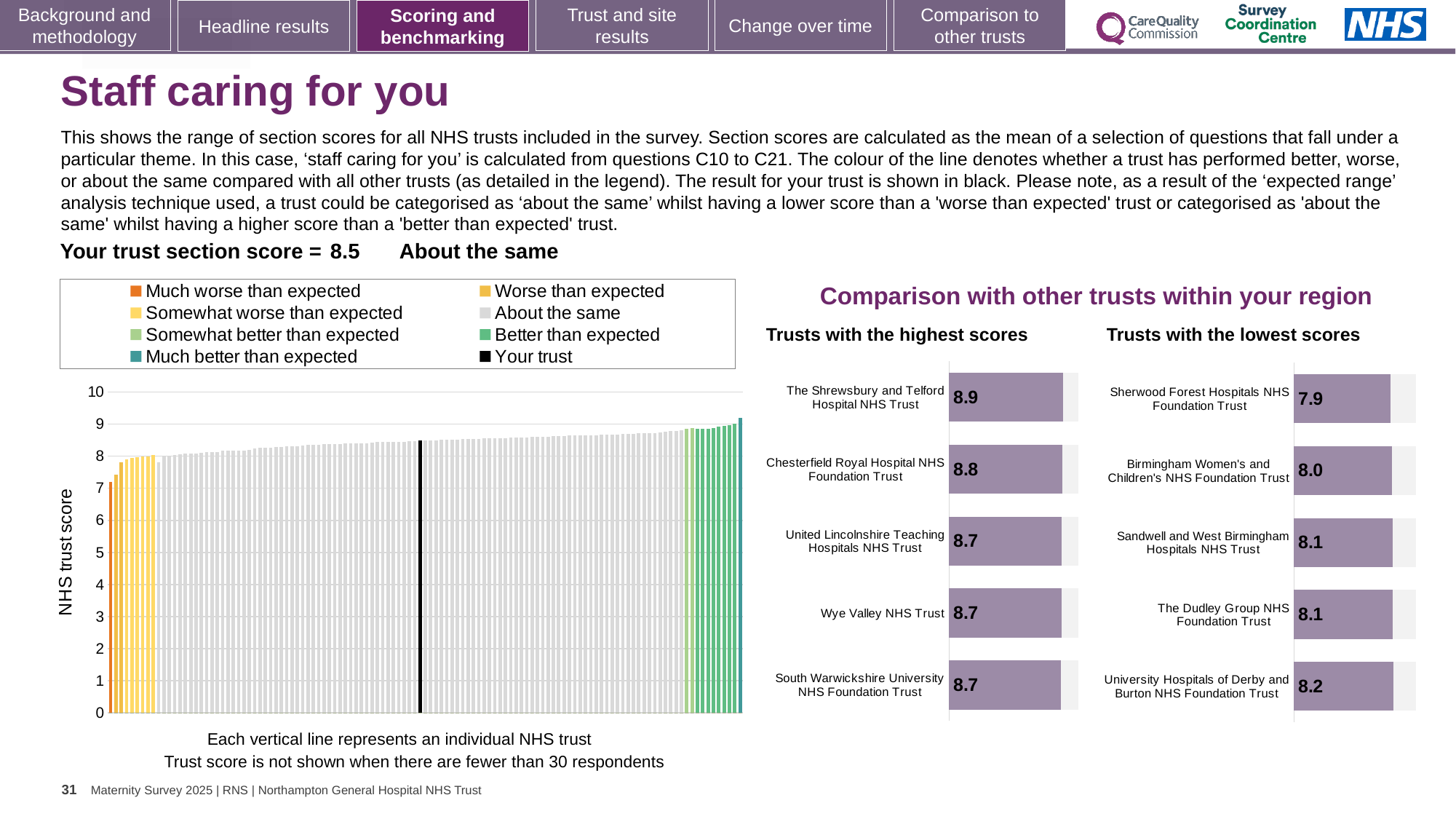
In the NHS trust score chart on the left, is the value of the leftmost (orange) bar greater or less than 8? less What is your trust's section score for 'Staff caring for you' as shown on the slide? 8.5 In the 'Trusts with the lowest scores' chart, what is the difference between the scores of University Hospitals of Derby and Burton NHS Foundation Trust and Sherwood Forest Hospitals NHS Foundation Trust? 0.3 How many entries does the legend of the NHS trust score chart on the left list? 8 In the 'Trusts with the lowest scores' chart, which has the larger score: Sandwell and West Birmingham Hospitals NHS Trust or University Hospitals of Derby and Burton NHS Foundation Trust? University Hospitals of Derby and Burton NHS Foundation Trust What kind of chart is the NHS trust score chart on the left of the slide? Bar chart In the 'Trusts with the highest scores' chart, which trust has the highest score? The Shrewsbury and Telford Hospital NHS Trust In the 'Trusts with the highest scores' chart, what is the score for The Shrewsbury and Telford Hospital NHS Trust? 8.9 In the 'Trusts with the lowest scores' chart, which trust has the lowest score? Sherwood Forest Hospitals NHS Foundation Trust In the 'Trusts with the lowest scores' chart, what is the score for Sherwood Forest Hospitals NHS Foundation Trust? 7.9 How many trusts are shown in the 'Trusts with the highest scores' chart? 5 In the NHS trust score chart on the left, do the values rise or fall from left to right? Rise